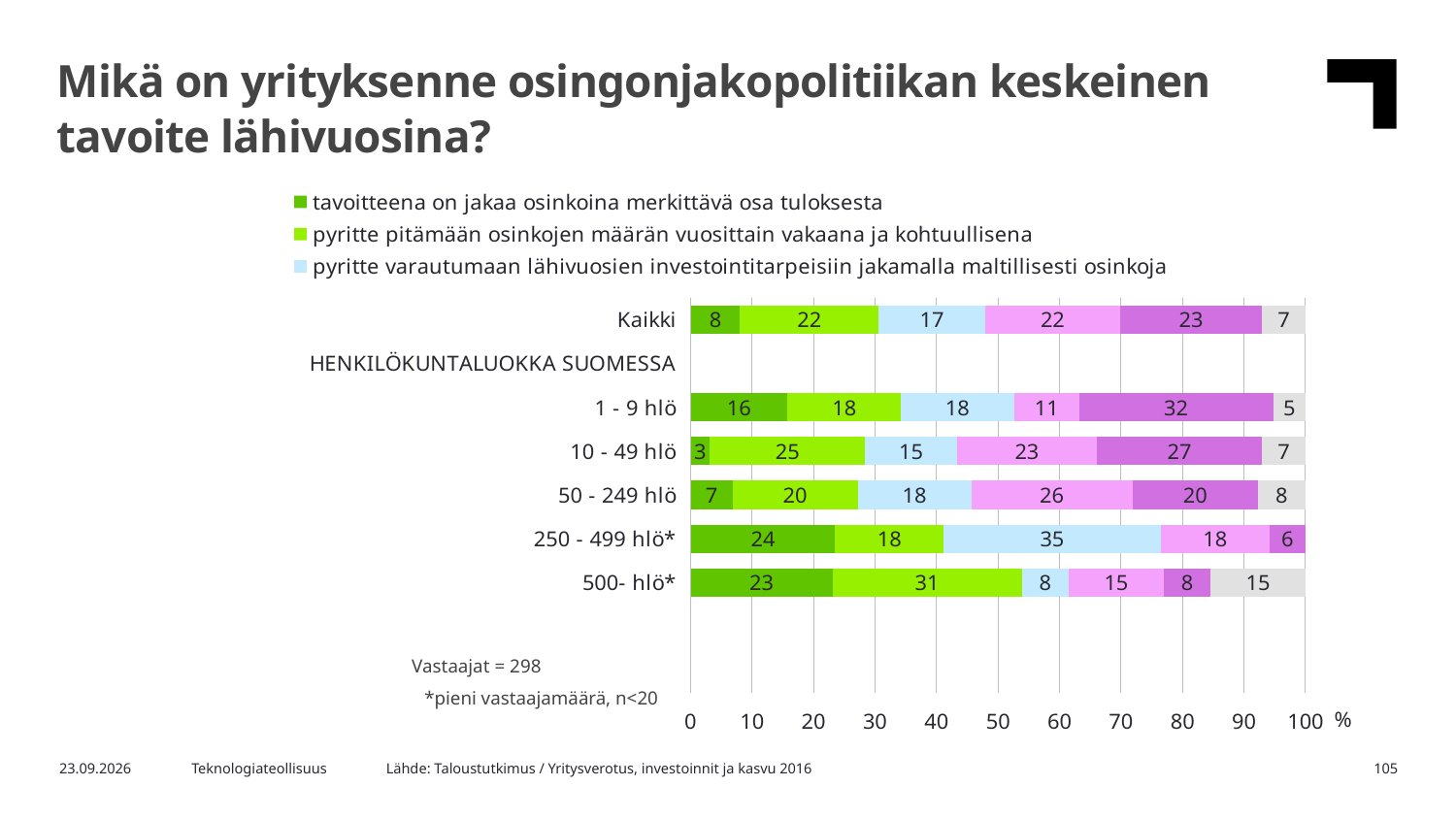
What is the value of the 'pyritte pitämään osinkojen määrän vuosittain vakaana ja kohtuullisena' segment for '500- hlö*'? 31 How many bars (respondent groups) are plotted in the chart? 6 What is the number of respondents stated below the chart (Vastaajat)? 298 Which group has the highest value for the 'pyritte pitämään osinkojen määrän vuosittain vakaana ja kohtuullisena' segment? 500- hlö* What is the difference between the first (dark green) segment values of '1 - 9 hlö' and '50 - 249 hlö'? 9 What is the value of the 'pyritte varautumaan lähivuosien investointitarpeisiin jakamalla maltillisesti osinkoja' segment for '250 - 499 hlö*'? 35 Which is larger: the light blue segment for '1 - 9 hlö' or for '10 - 49 hlö'? 1 - 9 hlö Which group has the lowest value for the 'tavoitteena on jakaa osinkoina merkittävä osa tuloksesta' segment? 10 - 49 hlö What is the total of all segments in the '1 - 9 hlö' bar? 100 What kind of chart is shown on the slide? stacked bar chart What is the value of the first (dark green) segment for the 'Kaikki' bar? 8 How many entries does the chart legend list? 3